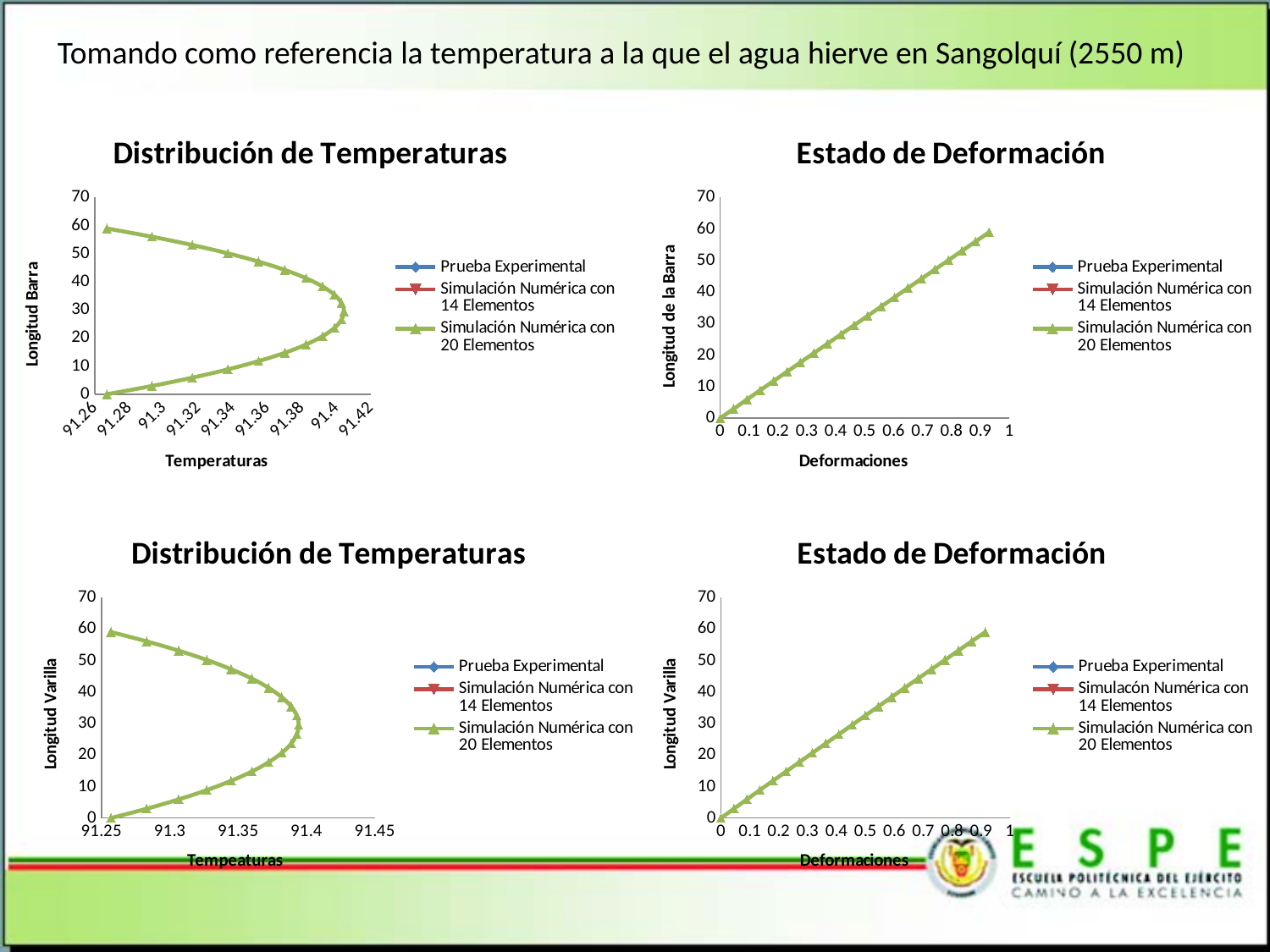
In the top-left chart titled 'Distribución de Temperaturas', how many series does the legend list? 3 In the top-left chart titled 'Distribución de Temperaturas', is the highest Longitud Barra value reached by the plotted curve greater or less than 50? greater In the top-right chart titled 'Estado de Deformación', is the highest Longitud de la Barra value reached by the plotted line greater or less than 50? greater What is the x-axis label of the bottom-right chart titled 'Estado de Deformación'? Deformaciones In the bottom-right chart titled 'Estado de Deformación', do the values of Longitud Varilla rise or fall as Deformaciones increases? rise In the bottom-left chart titled 'Distribución de Temperaturas', is the highest temperature plotted greater or less than 91.35? greater In the top-right chart titled 'Estado de Deformación', do the values of Longitud de la Barra rise or fall as Deformaciones increases? rise How many charts are shown on the slide? 4 In the bottom-left chart titled 'Distribución de Temperaturas', how many series does the legend list? 3 In the top-right chart titled 'Estado de Deformación', what kind of chart is it? line chart